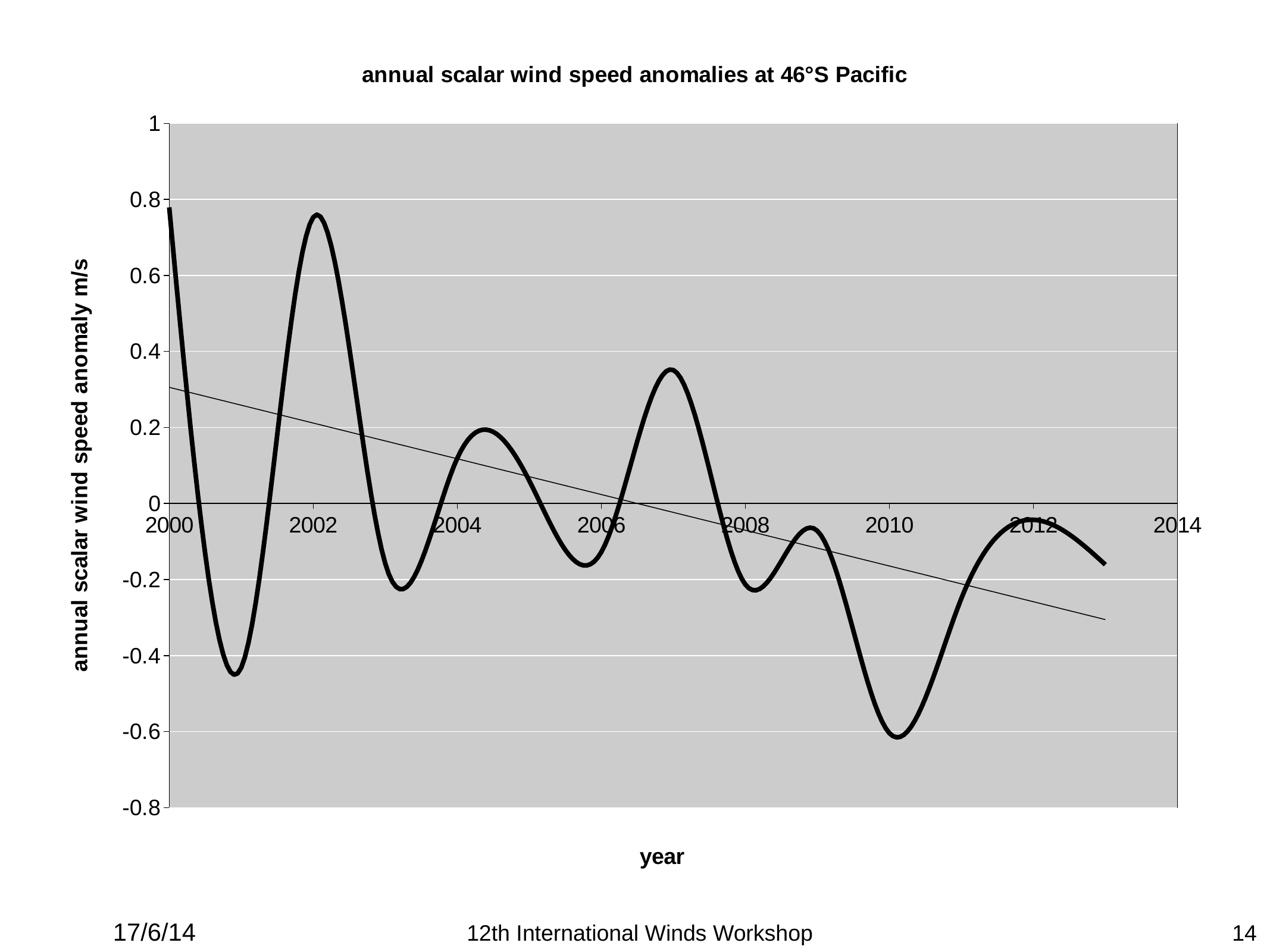
Is the value for 2002 greater or less than 0.6? greater Is the value for 2010 greater or less than -0.4? less Does the thin straight trend line rise or fall from 2000 to 2013? fall Is the value for 2000 greater or less than 0.6? greater What kind of chart is shown on the slide? line chart What is the label of the vertical axis? annual scalar wind speed anomaly m/s Which is larger, the value for 2002 or the value for 2010? 2002 In which year is the wind speed anomaly lowest? 2010 What is the title of the chart? annual scalar wind speed anomalies at 46°S Pacific